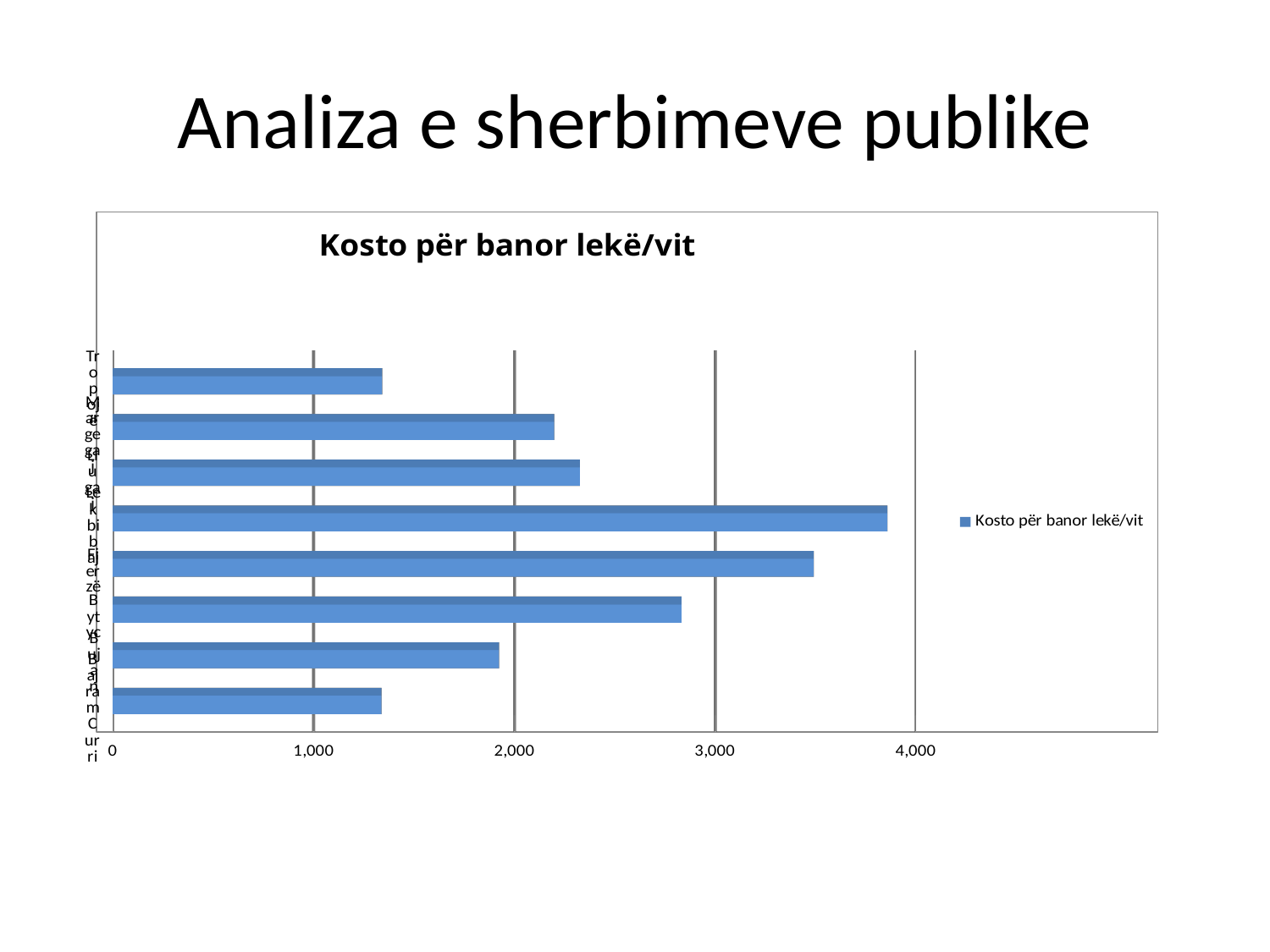
How many series does the legend list? 1 Is the value of the sixth bar from the top greater or less than 3,000? less Is the value of the seventh bar from the top greater or less than 2,000? less Is the value of the fourth bar from the top greater or less than 3,000? greater What is the title of the chart? Kosto për banor lekë/vit How many bars are plotted in the chart? 8 Which bar is the longest: the fourth bar from the top or the fifth bar from the top? the fourth bar from the top What type of chart is shown on the slide? bar chart What is the highest value labelled on the horizontal axis? 4,000 Which is larger: the sixth bar from the top or the seventh bar from the top? the sixth bar from the top